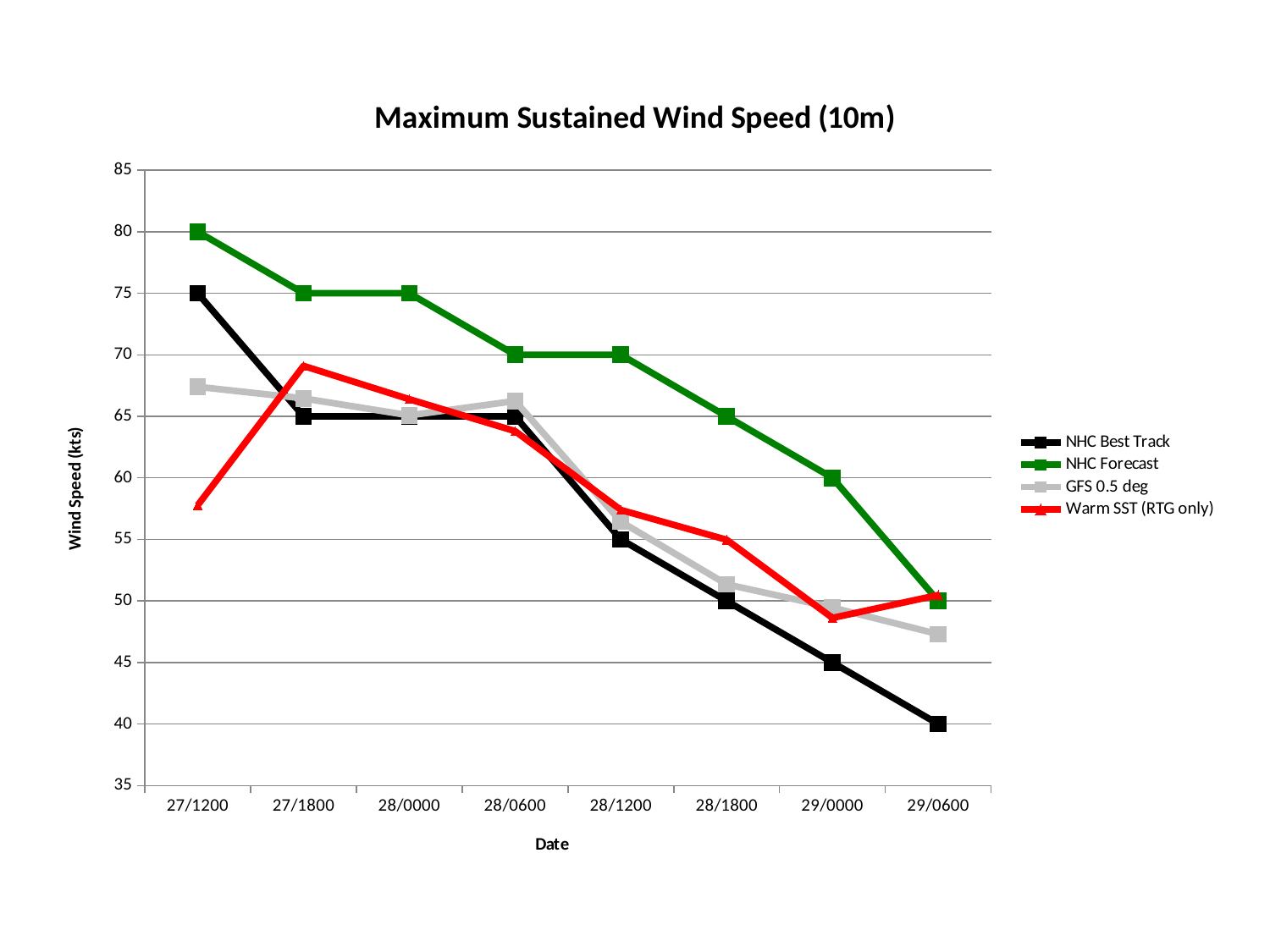
Which series has the highest value at 28/1800? NHC Forecast What is the NHC Forecast wind speed at 29/0600? 50 What is the difference between the NHC Forecast and NHC Best Track wind speeds at 29/0600? 10 What is the NHC Best Track wind speed at 27/1200? 75 Does the NHC Best Track series generally rise or fall from 27/1200 to 29/0600? fall What is the NHC Forecast wind speed at 27/1200? 80 How many dates are plotted along the x axis? 8 What is the NHC Best Track wind speed at 29/0600? 40 What kind of chart is shown on the slide? line chart Is the Warm SST (RTG only) value at 27/1200 greater or less than 60? less How many series does the legend list? 4 Is the GFS 0.5 deg value at 27/1200 greater or less than 65? greater